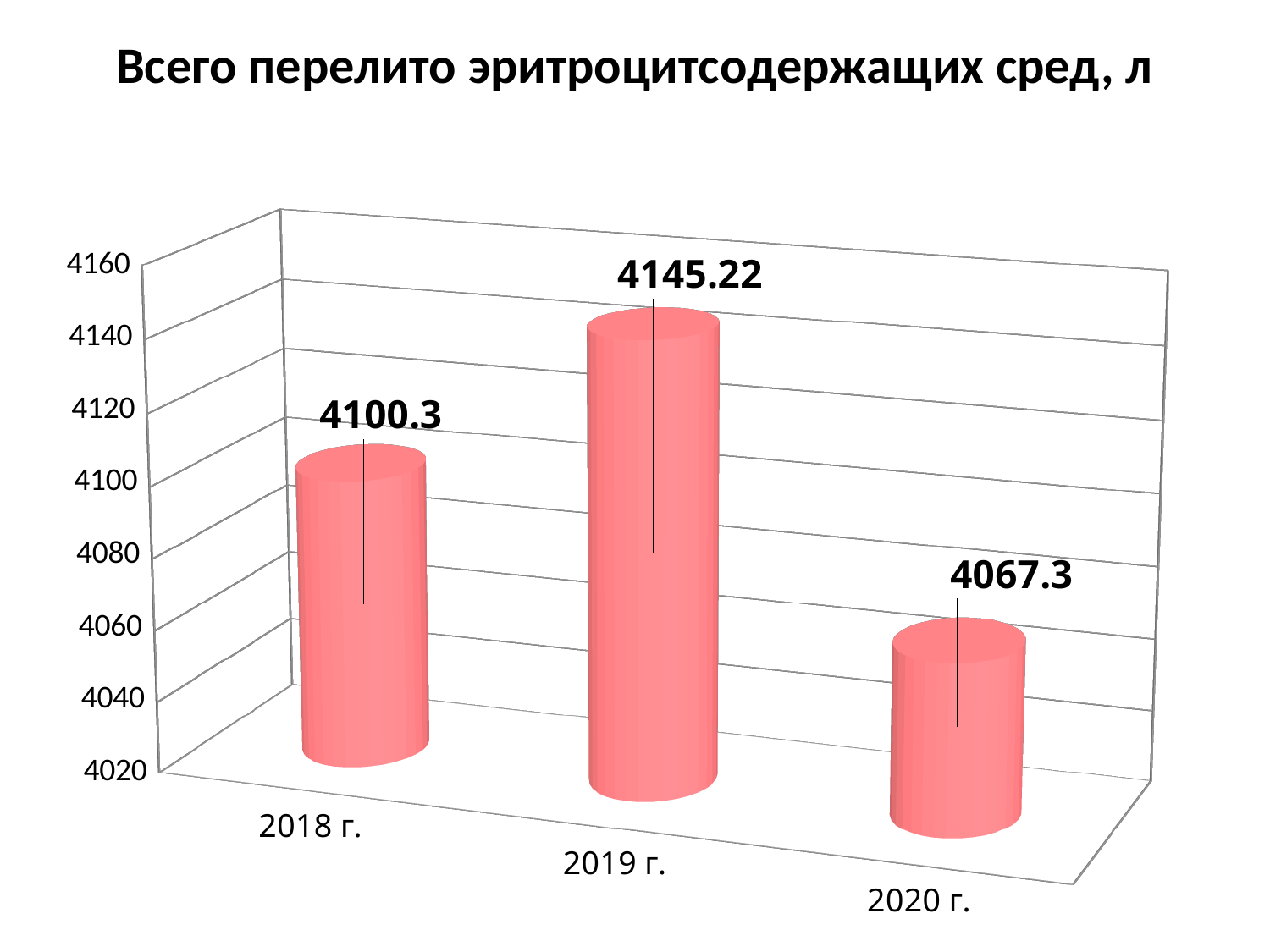
What kind of chart is shown on the slide? bar chart Which year has the lowest value? 2020 г. What is the value for 2018 г.? 4100.3 What is the value for 2019 г.? 4145.22 Which year has the highest value? 2019 г. What is the title of the chart? Всего перелито эритроцитсодержащих сред, л Which is larger, the value for 2018 г. or the value for 2020 г.? 2018 г. What is the value for 2020 г.? 4067.3 What is the difference between the values for 2018 г. and 2020 г.? 33 How many years are shown on the chart? 3 What is the difference between the values for 2019 г. and 2018 г.? 44.92 Is the value for 2020 г. greater or less than 4080? less